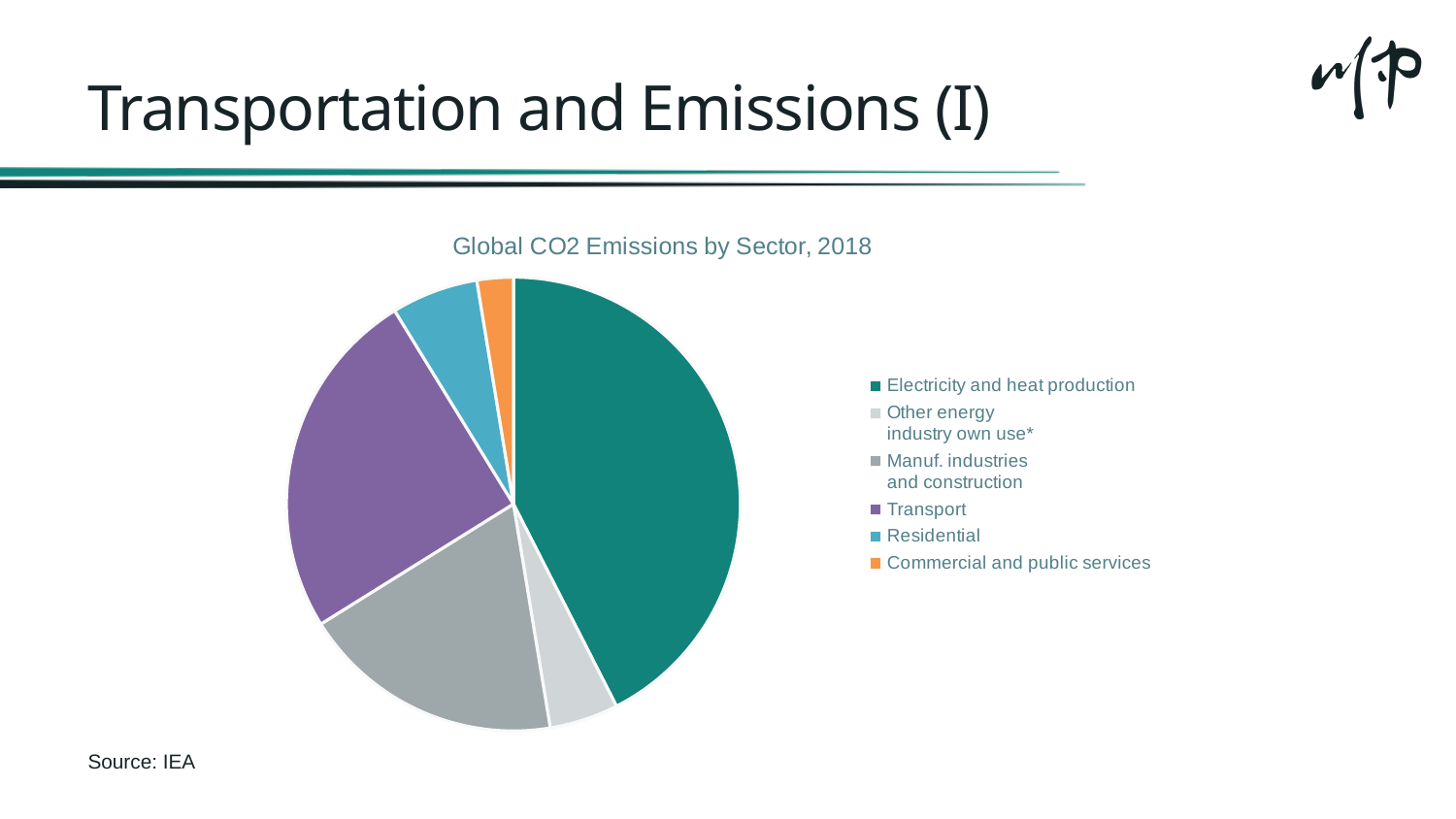
What is the title of the chart? Global CO2 Emissions by Sector, 2018 Which slice is larger, Manuf. industries and construction or Other energy industry own use*? Manuf. industries and construction Which slice is larger, Electricity and heat production or Transport? Electricity and heat production What source is cited for the chart data? IEA Which slice is larger, Residential or Commercial and public services? Residential How many sectors (slices) does the pie chart show? 6 Which sector has the largest share of global CO2 emissions in the chart? Electricity and heat production What kind of chart is shown on the slide? Pie chart Which sector has the smallest slice in the pie chart? Commercial and public services